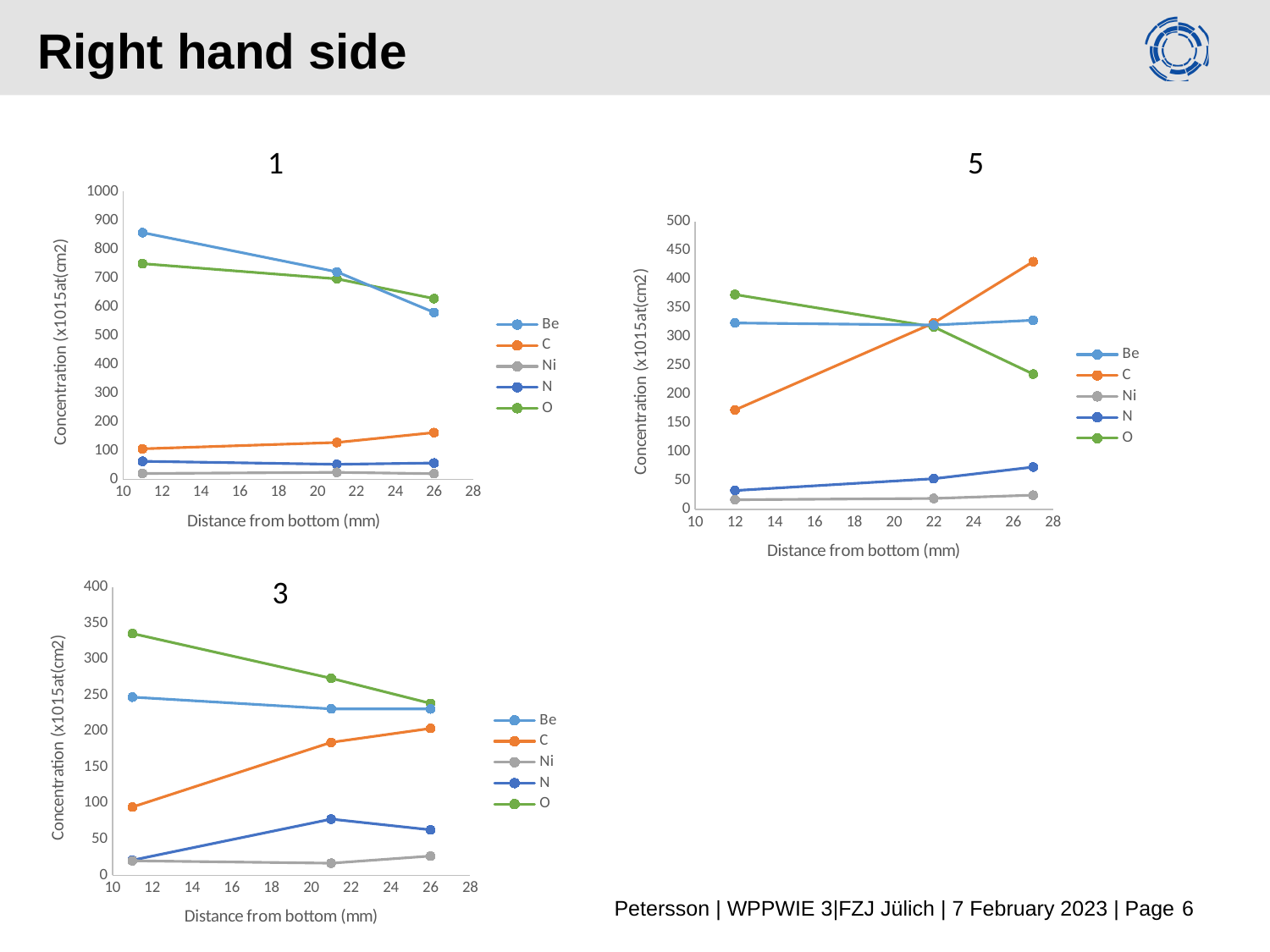
In the chart titled "5", does the C series rise or fall as distance from bottom increases? rise In the chart titled "5", how many series does the legend list? 5 In the chart titled "5", at 27 mm, which is larger: the C value or the Be value? C In the chart titled "3", which series has the highest value at 11 mm? O In the chart titled "3", how many data points does the Be series have? 3 In the chart titled "1", which series has the lowest value at 26 mm? Ni In the chart titled "3", is the O value at 11 mm greater or less than 300? greater In the chart titled "5", is the C value at 27 mm greater or less than 400? greater In the chart titled "3", what is the x-axis title? Distance from bottom (mm) In the chart titled "1", is the Be value at 11 mm greater or less than 800? greater In the chart titled "1", what kind of chart is shown? line chart In the chart titled "1", does the Be series rise or fall as distance from bottom increases? fall